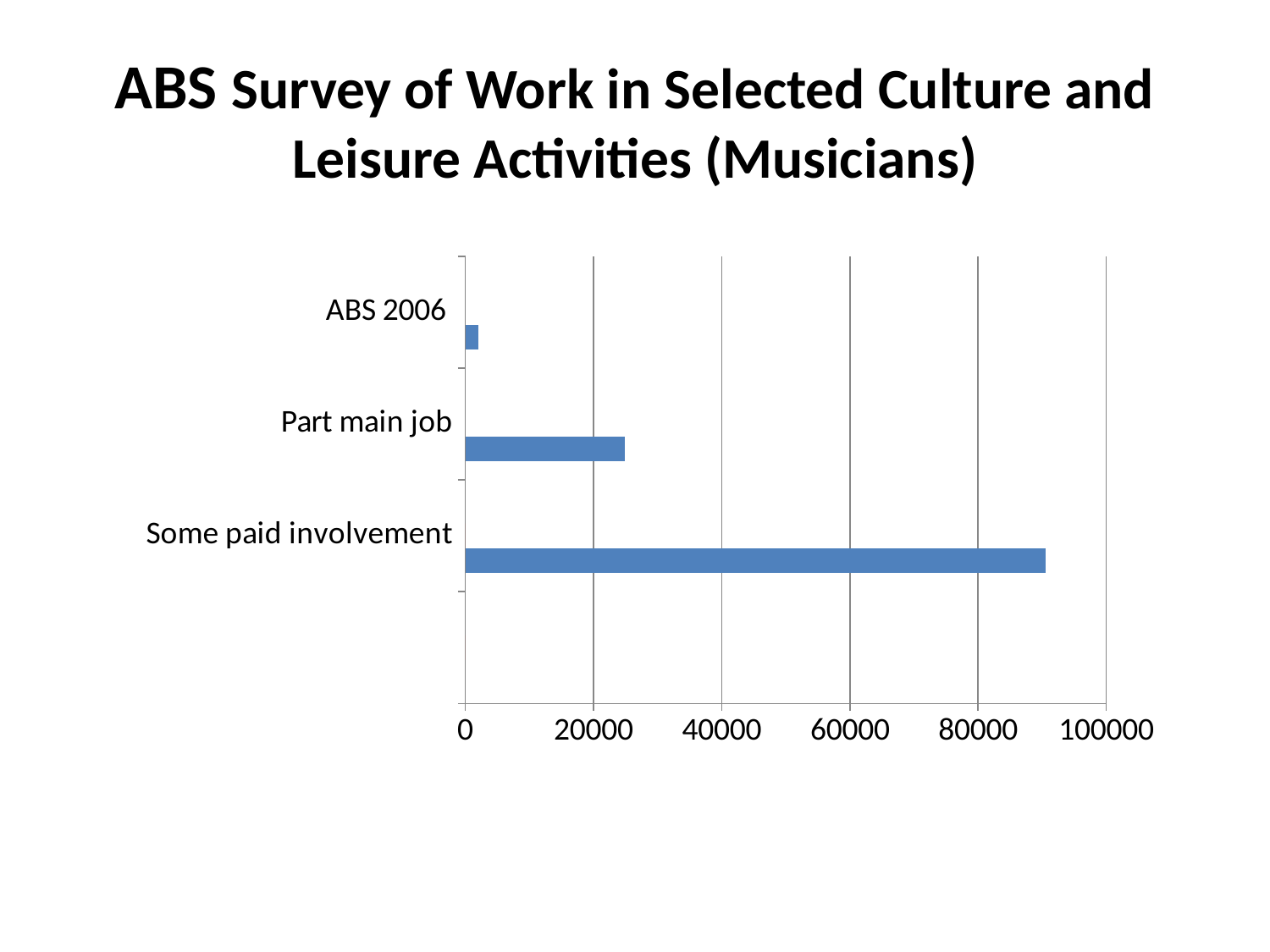
Is the value for Some paid involvement greater or less than 100000? less Is the value for Part main job greater or less than 40000? less What is the highest value shown on the horizontal axis of the chart? 100000 Is the value for Some paid involvement greater or less than 80000? greater Which category has the lowest value? ABS 2006 What is the title of the slide containing the chart? ABS Survey of Work in Selected Culture and Leisure Activities (Musicians) What kind of chart is shown on the slide? Bar chart Which is larger, the value for Some paid involvement or the value for Part main job? Some paid involvement How many categories are plotted in the chart? 3 Which category has the highest value? Some paid involvement Which is larger, the value for Part main job or the value for ABS 2006? Part main job